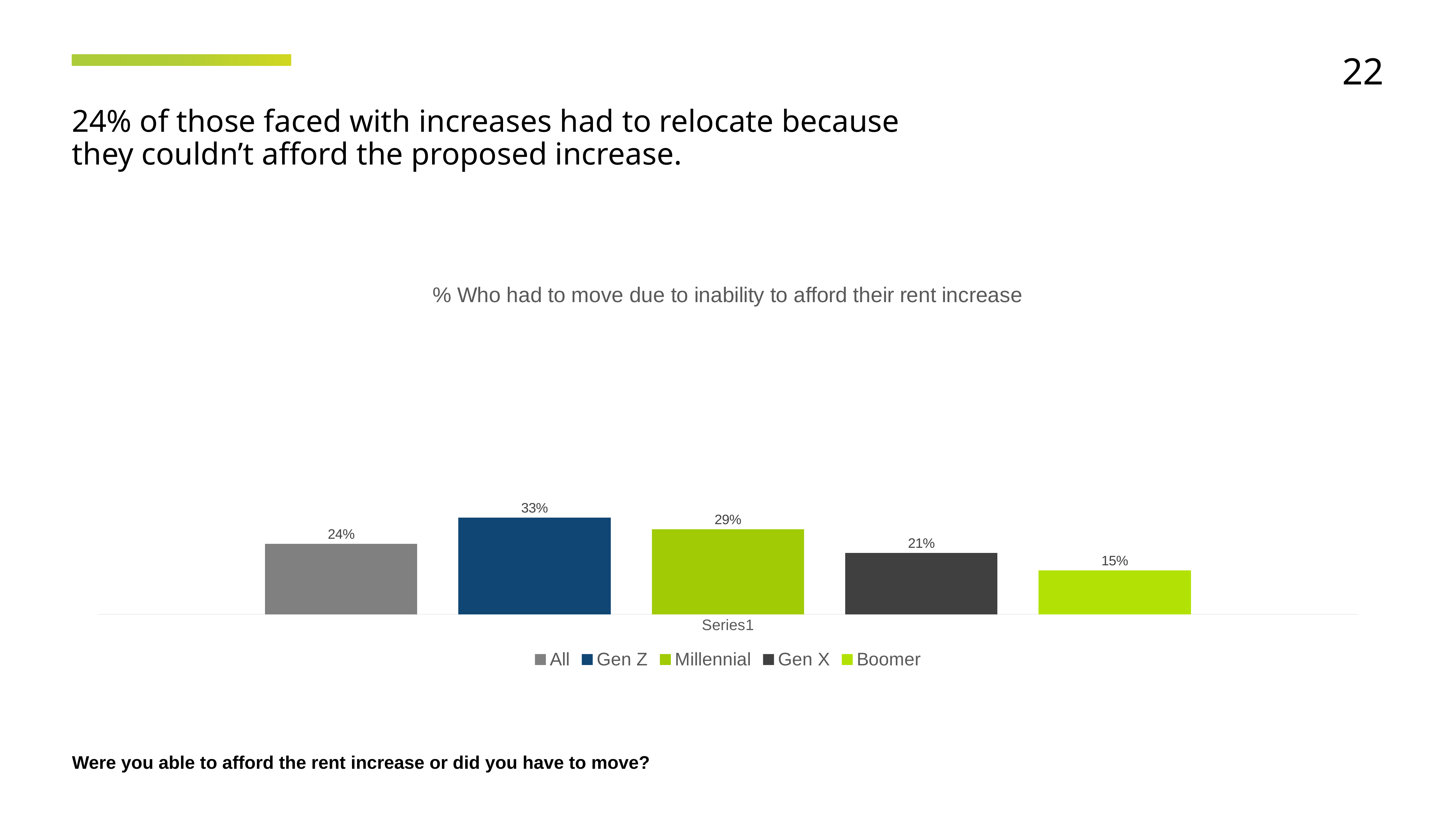
Which is larger, the value for Gen X or the value for All? All What is the value for Millennial? 29% What is the difference between the values for Millennial and Gen X? 8% What kind of chart is shown? Bar chart Which group has the lowest value? Boomer Which group has the highest value? Gen Z What is the value for Boomer? 15% What is the value for All? 24% What is the value for Gen Z? 33% What is the difference between the values for Gen Z and Boomer? 18% What is the title of the chart? % Who had to move due to inability to afford their rent increase How many series does the legend list? 5